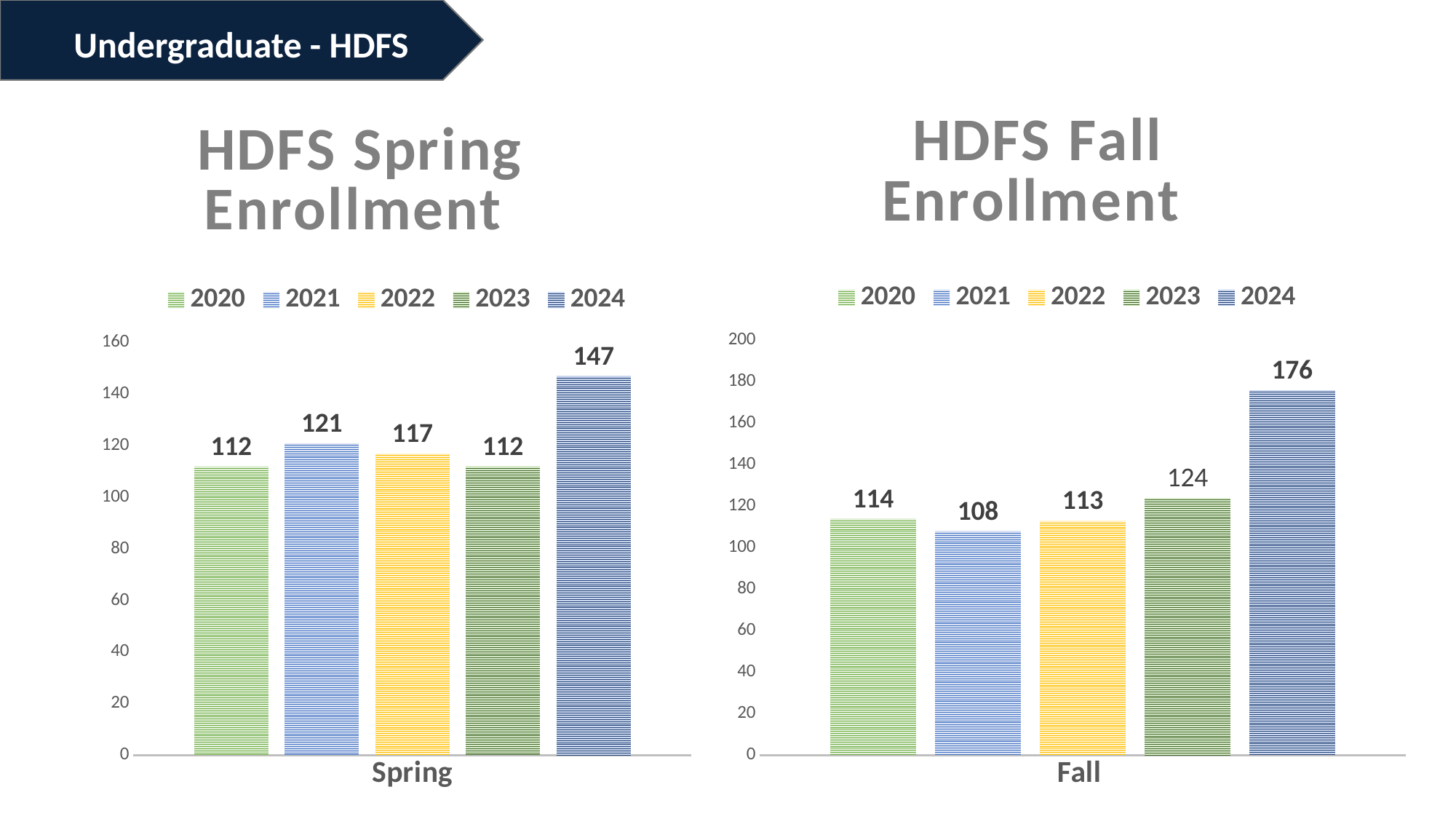
In the HDFS Fall Enrollment chart, what is the difference between the 2024 and 2020 values? 62 In the HDFS Fall Enrollment chart, what is the value for 2023? 124 In the HDFS Spring Enrollment chart, what is the value for 2024? 147 In the HDFS Spring Enrollment chart, which year has the highest enrollment? 2024 What kind of chart is the HDFS Spring Enrollment chart? bar chart In the HDFS Fall Enrollment chart, is the value for 2024 greater or less than 160? greater What is the x-axis category label on the HDFS Fall Enrollment chart? Fall How many series does the legend of the HDFS Fall Enrollment chart list? 5 In the HDFS Spring Enrollment chart, what is the difference between the 2024 and 2021 values? 26 In the HDFS Spring Enrollment chart, which is larger, the value for 2021 or the value for 2022? 2021 In the HDFS Fall Enrollment chart, what is the value for 2021? 108 In the HDFS Fall Enrollment chart, which year has the lowest enrollment? 2021